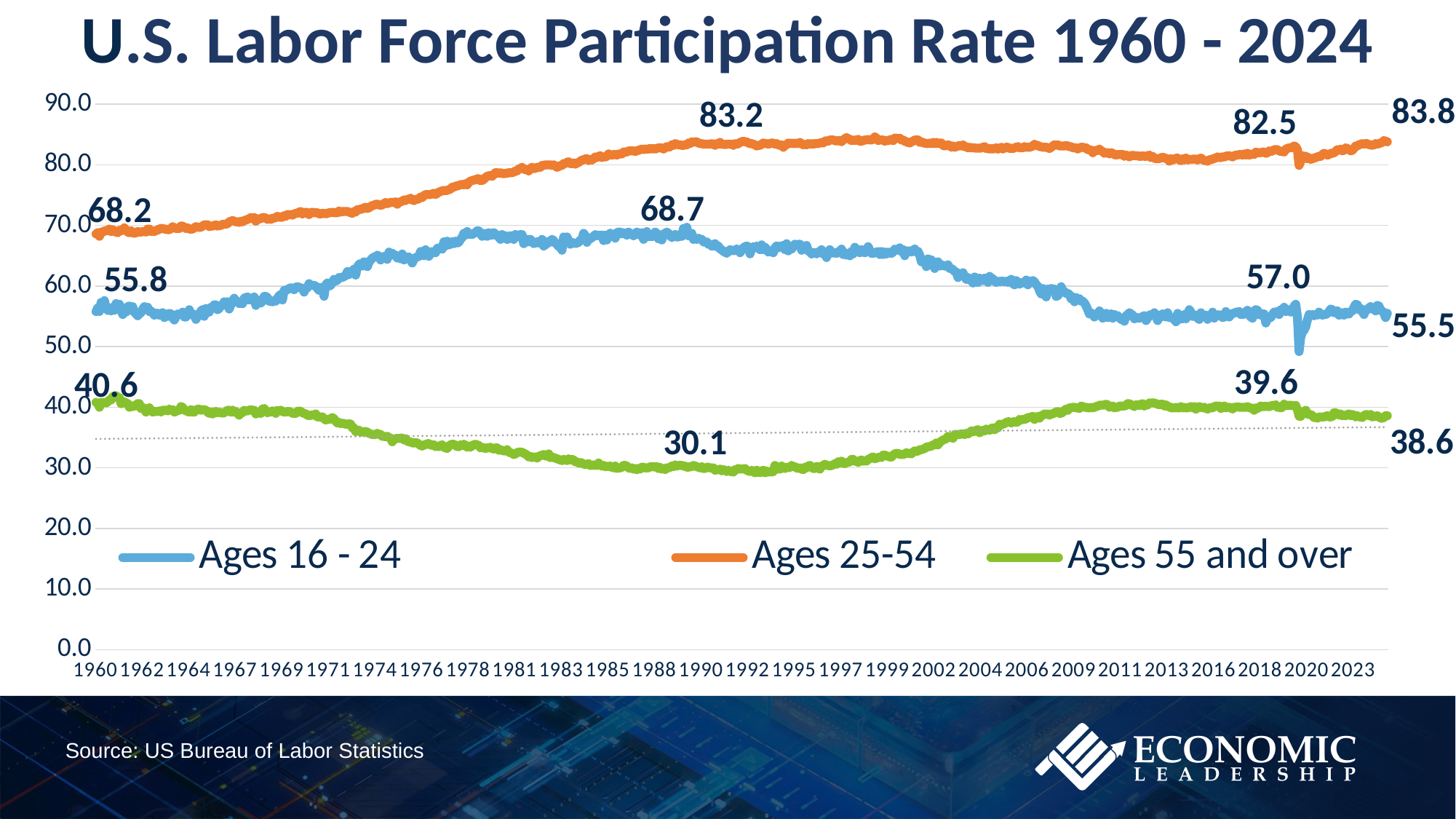
What is the final labeled value (at the right end of the line) for Ages 25-54? 83.8 Which age group has the highest labor force participation rate throughout the chart? Ages 25-54 What type of chart is shown on the slide? line chart What is the labeled value for Ages 25-54 at the start of the series in 1960? 68.2 How many series does the legend list? 3 What is the lowest value labeled on the Ages 55 and over line? 30.1 What is the title of the chart? U.S. Labor Force Participation Rate 1960 - 2024 What is the labeled value for Ages 55 and over at the start of the series in 1960? 40.6 What is the final labeled value (at the right end of the line) for Ages 16 - 24? 55.5 What is the final labeled value (at the right end of the line) for Ages 55 and over? 38.6 What is the labeled value for Ages 16 - 24 at the start of the series in 1960? 55.8 What is the peak value labeled on the Ages 16 - 24 line? 68.7